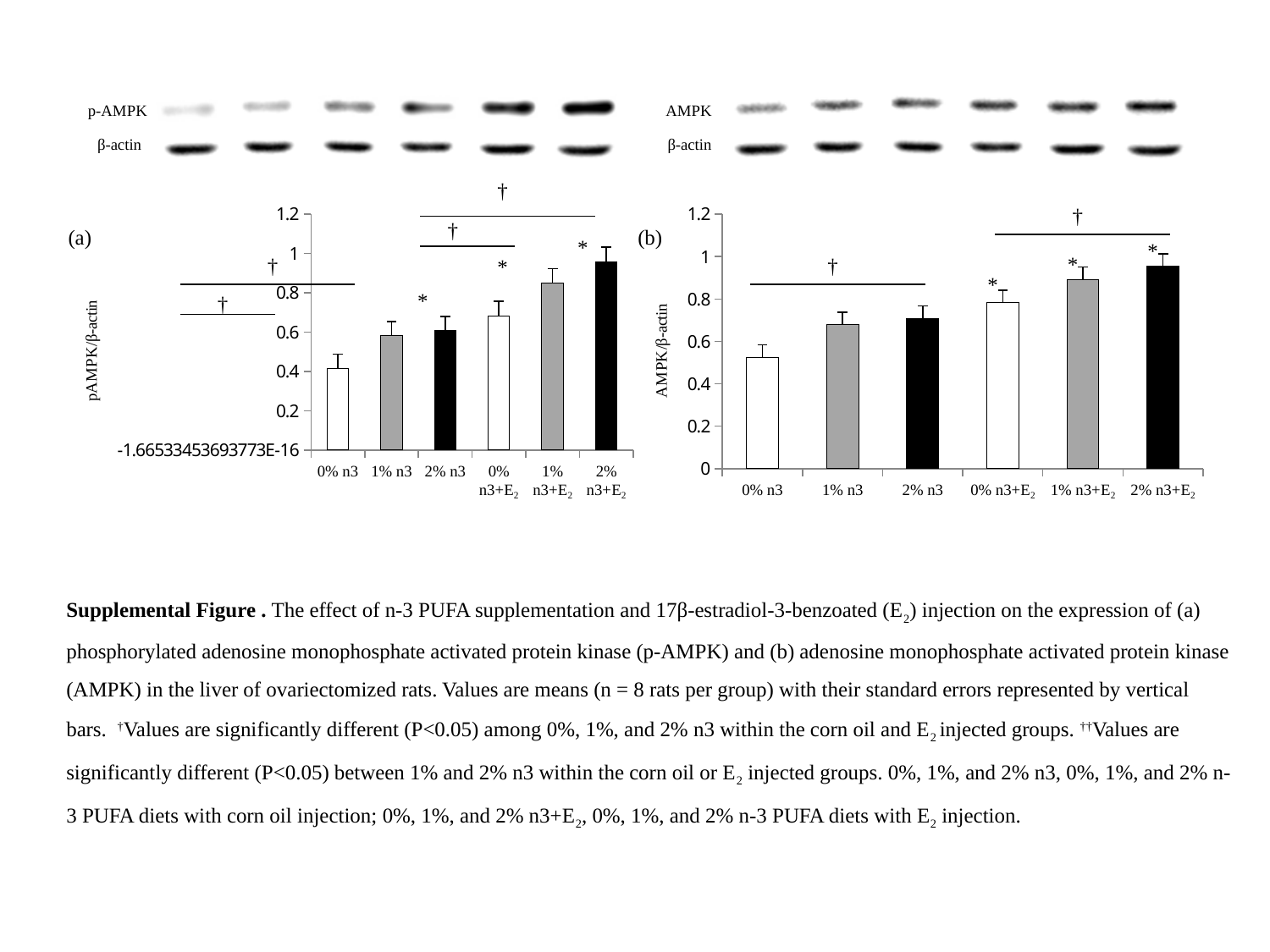
What is the y-axis label of chart (b)? AMPK/β-actin In chart (b), AMPK/β-actin, is the value for 1% n3+E2 greater or less than 0.8? greater In chart (b), AMPK/β-actin, which category has the highest bar? 2% n3+E2 In chart (b), AMPK/β-actin, which category has the lowest bar? 0% n3 In chart (a), pAMPK/β-actin, which category has the lowest bar? 0% n3 In chart (a), pAMPK/β-actin, which is larger: the value for 0% n3 or the value for 1% n3+E2? 1% n3+E2 What kind of chart is chart (a), pAMPK/β-actin? bar chart In chart (a), pAMPK/β-actin, is the value for 1% n3+E2 greater or less than 0.8? greater In chart (a), pAMPK/β-actin, which category has the highest bar? 2% n3+E2 In chart (b), AMPK/β-actin, is the value for 0% n3 greater or less than 0.6? less How many bars (categories) are plotted in chart (b), AMPK/β-actin? 6